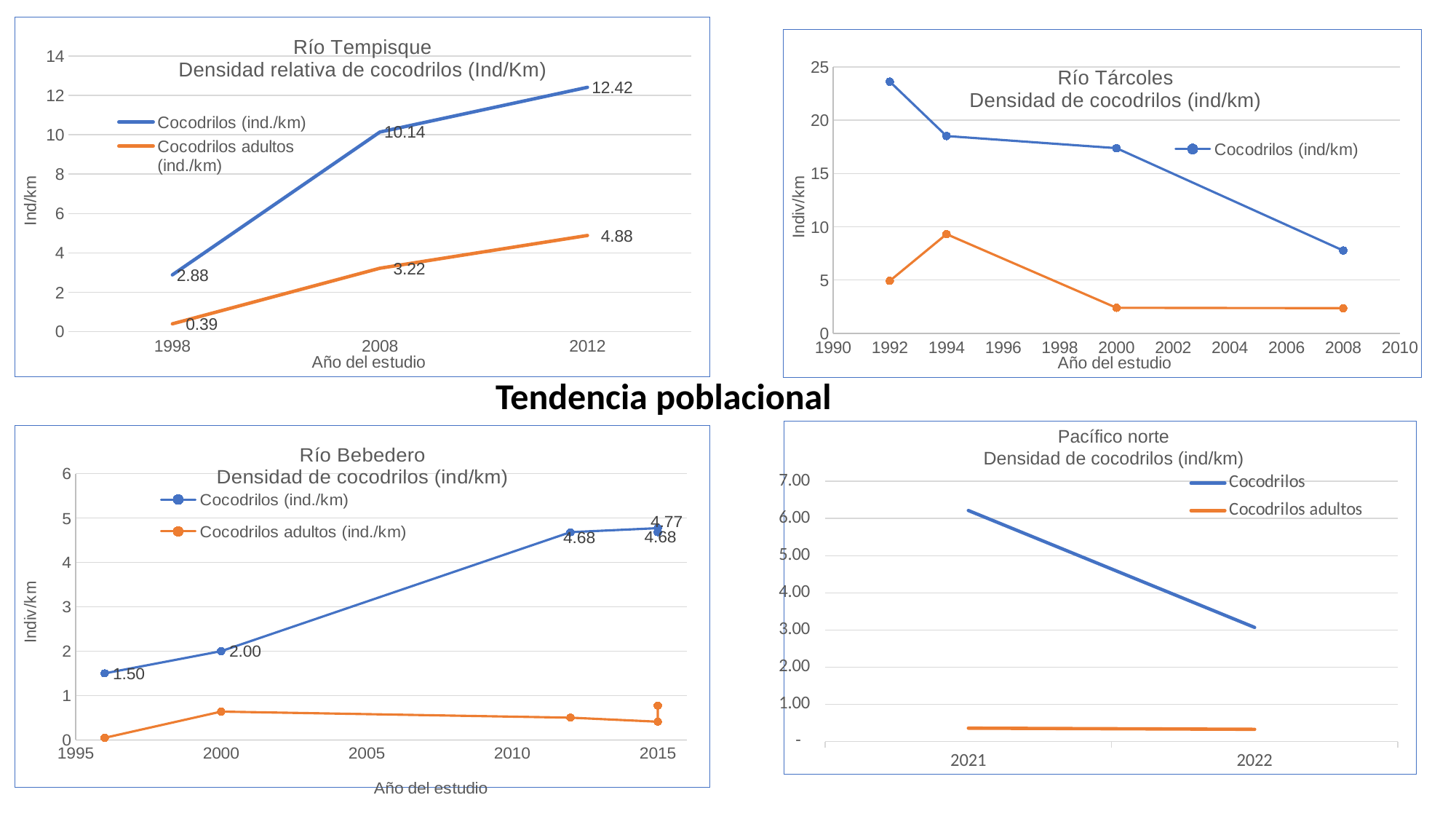
In the Pacífico norte chart, is the value for Cocodrilos in 2021 greater or less than 5.00? greater In the Río Tempisque chart, what is the value for Cocodrilos adultos (ind./km) in 1998? 0.39 In the Río Bebedero chart, what is the value for Cocodrilos (ind./km) in 2000? 2.00 How many series does the legend of the Río Tempisque chart list? 2 In the Río Tárcoles chart, is the value for Cocodrilos (ind/km) in 2008 greater or less than 10? less In the Río Tempisque chart, what is the difference between Cocodrilos (ind./km) and Cocodrilos adultos (ind./km) in 2008? 6.92 What kind of chart is the Pacífico norte chart? line chart In the Río Tárcoles chart, which year has the highest value for Cocodrilos (ind/km)? 1992 In the Río Tempisque chart, does the Cocodrilos (ind./km) series rise or fall from 1998 to 2012? rise In the Río Tárcoles chart, does the blue Cocodrilos (ind/km) series rise or fall from 1992 to 2008? fall In the Río Tempisque chart, what is the value for Cocodrilos (ind./km) in 2012? 12.42 In the Río Bebedero chart, what is the difference between the Cocodrilos (ind./km) values in 2000 and 1996? 0.50